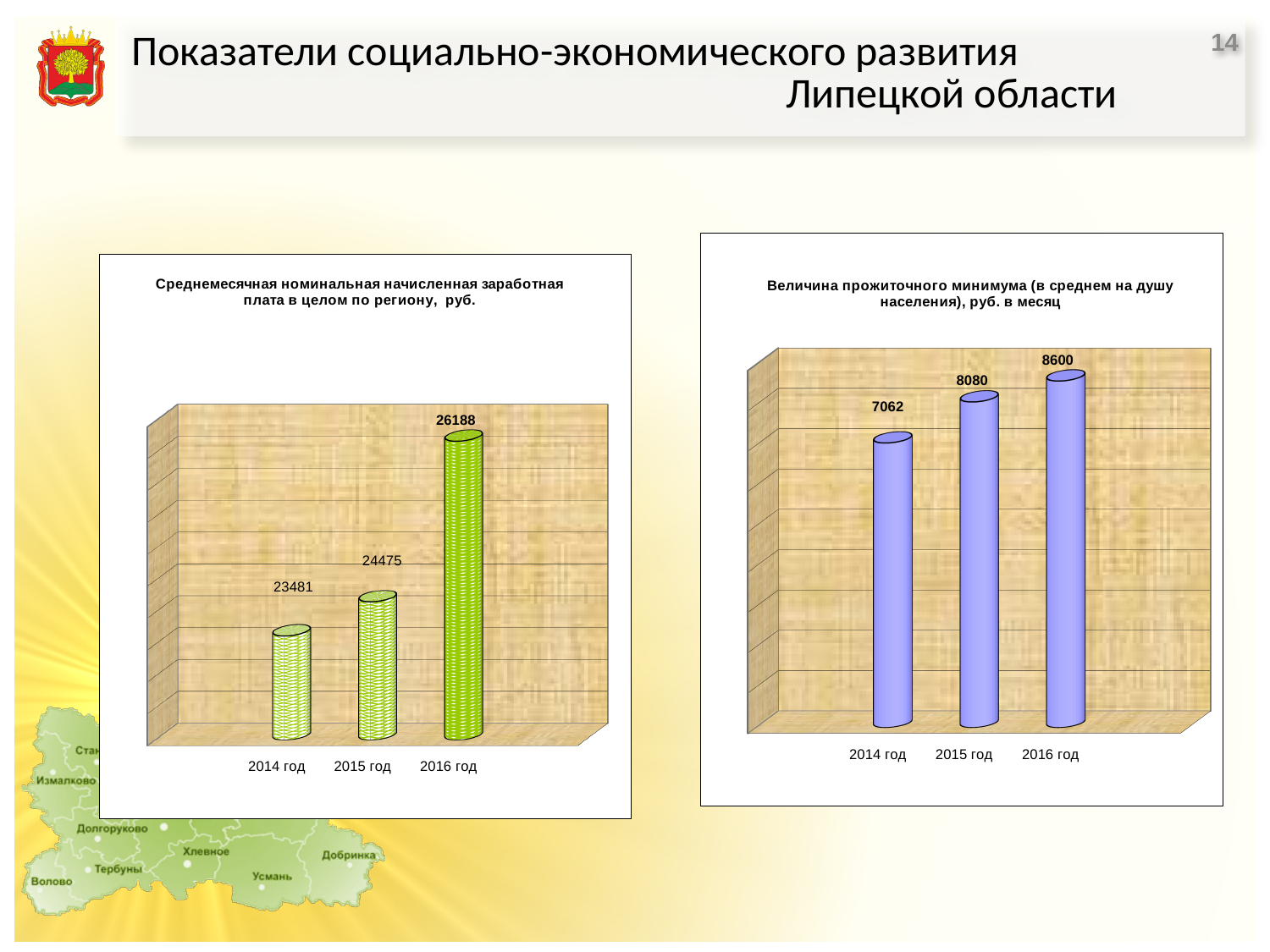
In the left chart (Среднемесячная номинальная начисленная заработная плата), which year has the highest value? 2016 год How many years are shown in the left chart (Среднемесячная номинальная начисленная заработная плата)? 3 What kind of chart is the right chart (Величина прожиточного минимума)? Bar chart In the right chart (Величина прожиточного минимума), which year has the lowest value? 2014 год In the left chart (Среднемесячная номинальная начисленная заработная плата), what is the value for 2014 год? 23481 In the left chart (Среднемесячная номинальная начисленная заработная плата), what is the difference between the 2016 год and 2015 год values? 1713 In the left chart (Среднемесячная номинальная начисленная заработная плата), what is the value for 2016 год? 26188 In the right chart (Величина прожиточного минимума), what is the value for 2015 год? 8080 In the right chart (Величина прожиточного минимума), what is the difference between the 2016 год and 2014 год values? 1538 In the left chart (Среднемесячная номинальная начисленная заработная плата), do the values rise or fall from 2014 год to 2016 год? Rise In the right chart (Величина прожиточного минимума), what is the value for 2014 год? 7062 In the right chart (Величина прожиточного минимума), which is larger: the value for 2015 год or 2016 год? 2016 год